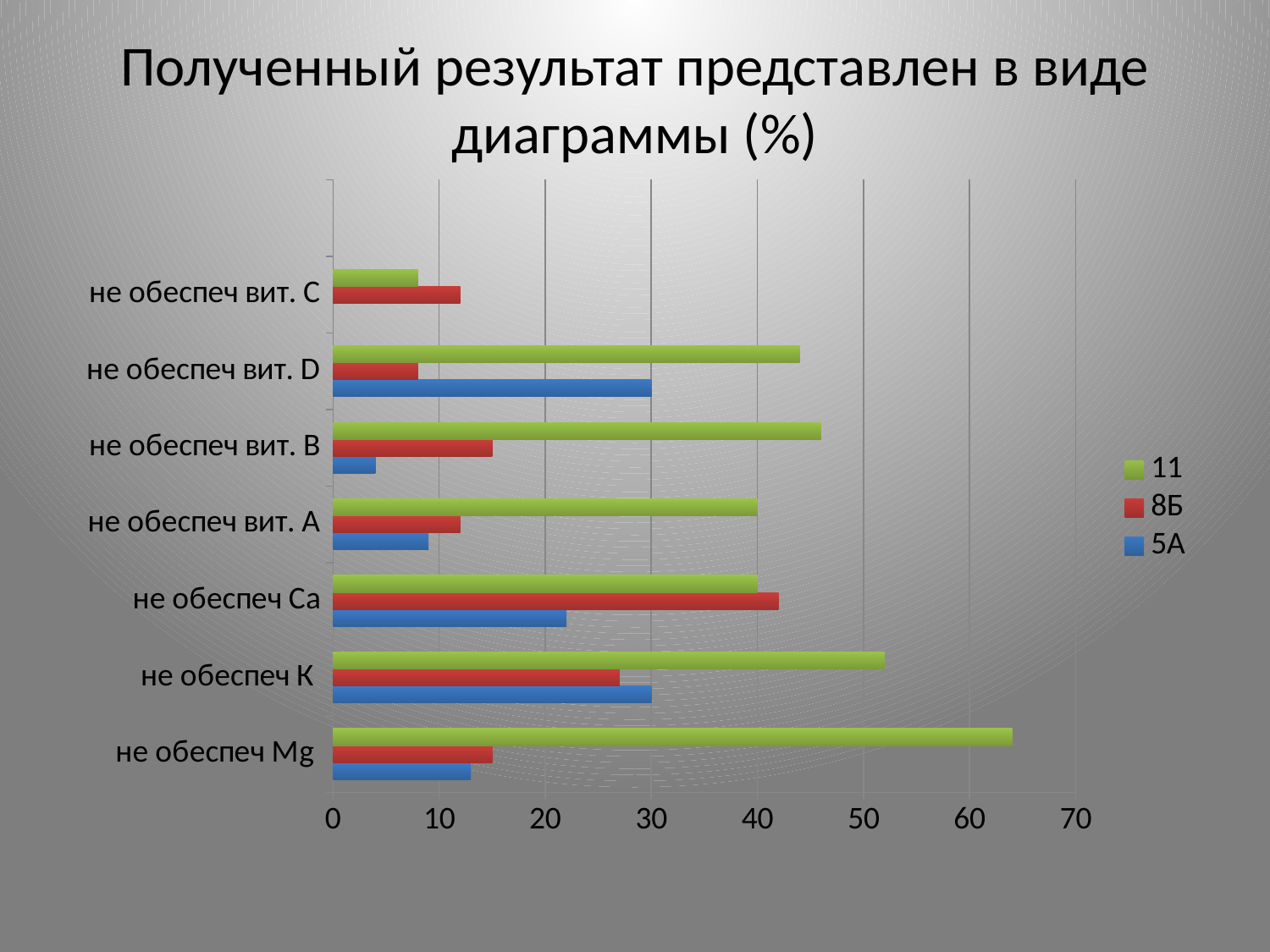
Is the value for series 11 in the category не обеспеч Mg greater or less than 60? greater How many categories are shown on the vertical axis of the chart? 7 How many series does the legend list? 3 Is the value for series 5А in the category не обеспеч вит. B greater or less than 10? less Which series and category has the longest bar in the chart? 11, не обеспеч Mg Is the value for series 11 in the category не обеспеч K greater or less than 50? greater For the series 11, which category has the highest value? не обеспеч Mg For the category не обеспеч вит. B, which series has the larger value: 8Б or 5А? 8Б What kind of chart is shown on the slide? bar chart What is the title of the chart slide? Полученный результат представлен в виде диаграммы (%)